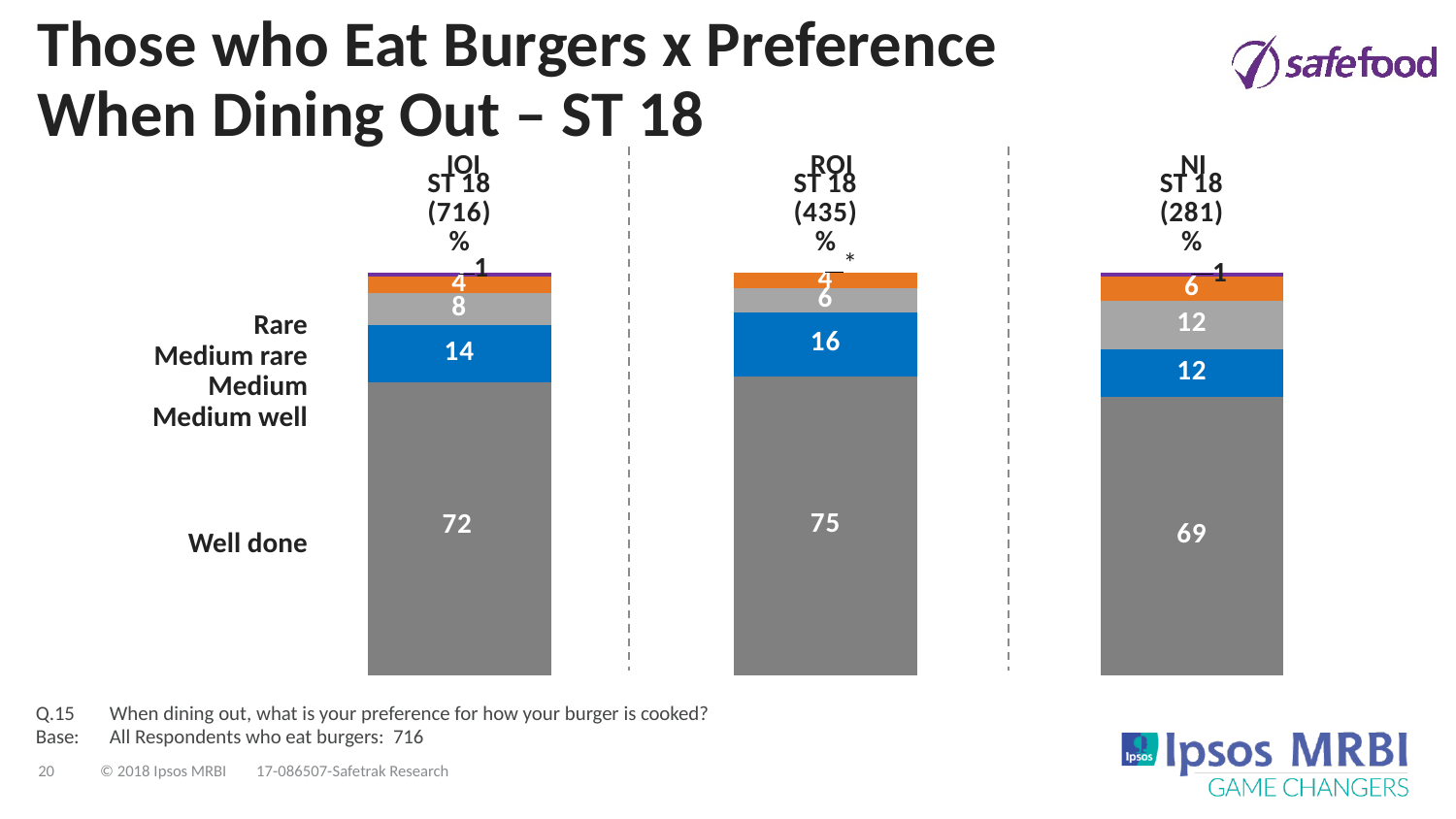
What type of chart is shown on the slide? Stacked bar chart Which region has the lowest well done percentage? NI What percentage of ROI respondents prefer their burger well done? 75 What is the medium rare value for NI? 6 How many regions (bars) are shown on the chart? 3 Which region has the highest well done percentage? ROI What is the medium well value for ROI? 16 Is the medium well value larger for IOI or NI? IOI What percentage of NI respondents prefer their burger well done? 69 What is the difference between the well done percentages for ROI and NI? 6 What percentage of IOI respondents prefer their burger well done? 72 What is the base size shown for the ROI bar? 435